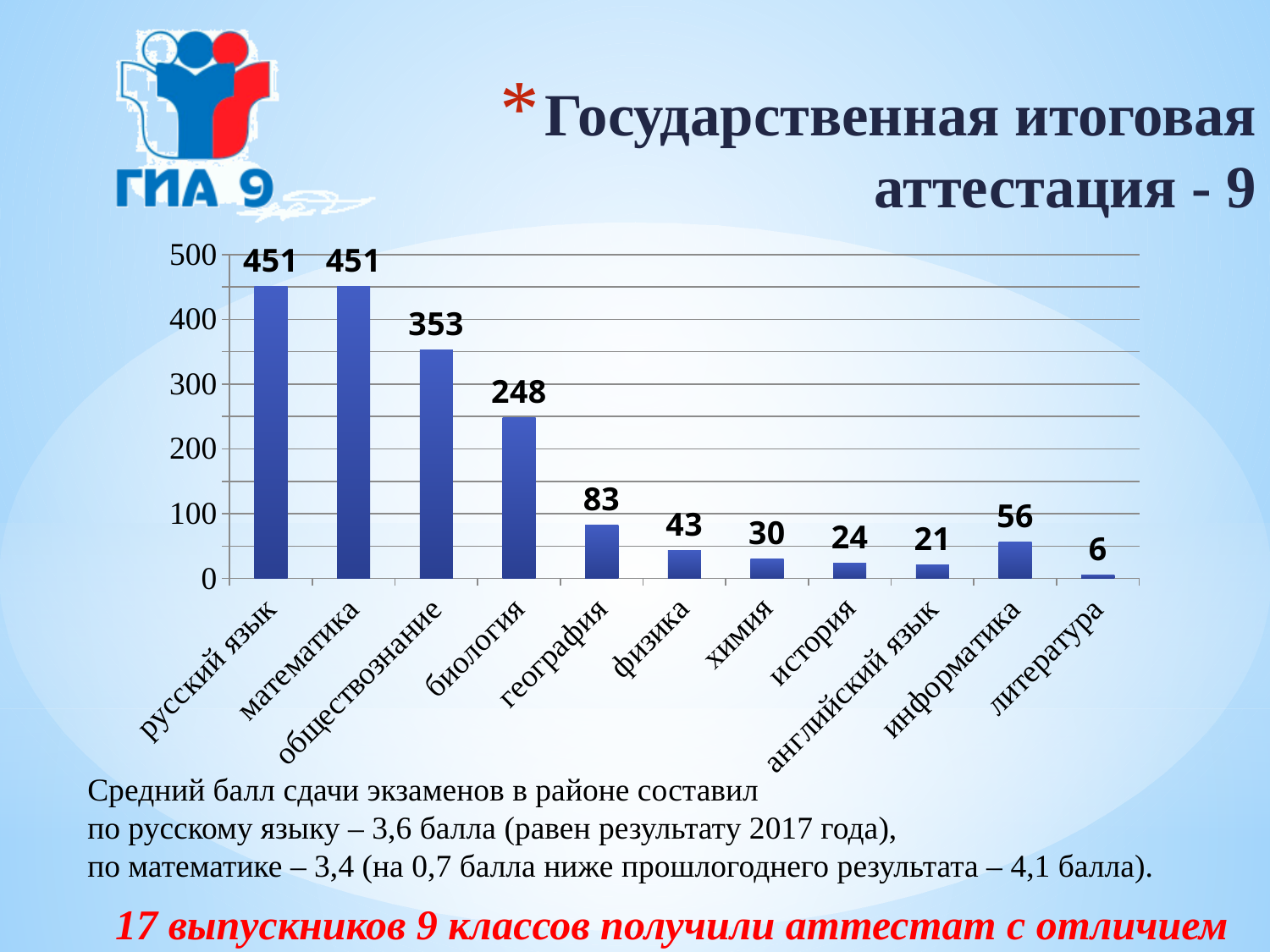
What type of chart is shown on the slide? bar chart What is the value for биология? 248 How many categories (subjects) are shown on the chart? 11 What is the value for обществознание? 353 What is the difference between the values for география and физика? 40 What is the difference between the values for русский язык and обществознание? 98 Which has a larger value, химия or информатика? информатика Which subject has the lowest value on the chart? литература Is the value for биология greater or less than 200? greater What is the value for математика? 451 What is the value for английский язык? 21 What is the value for информатика? 56